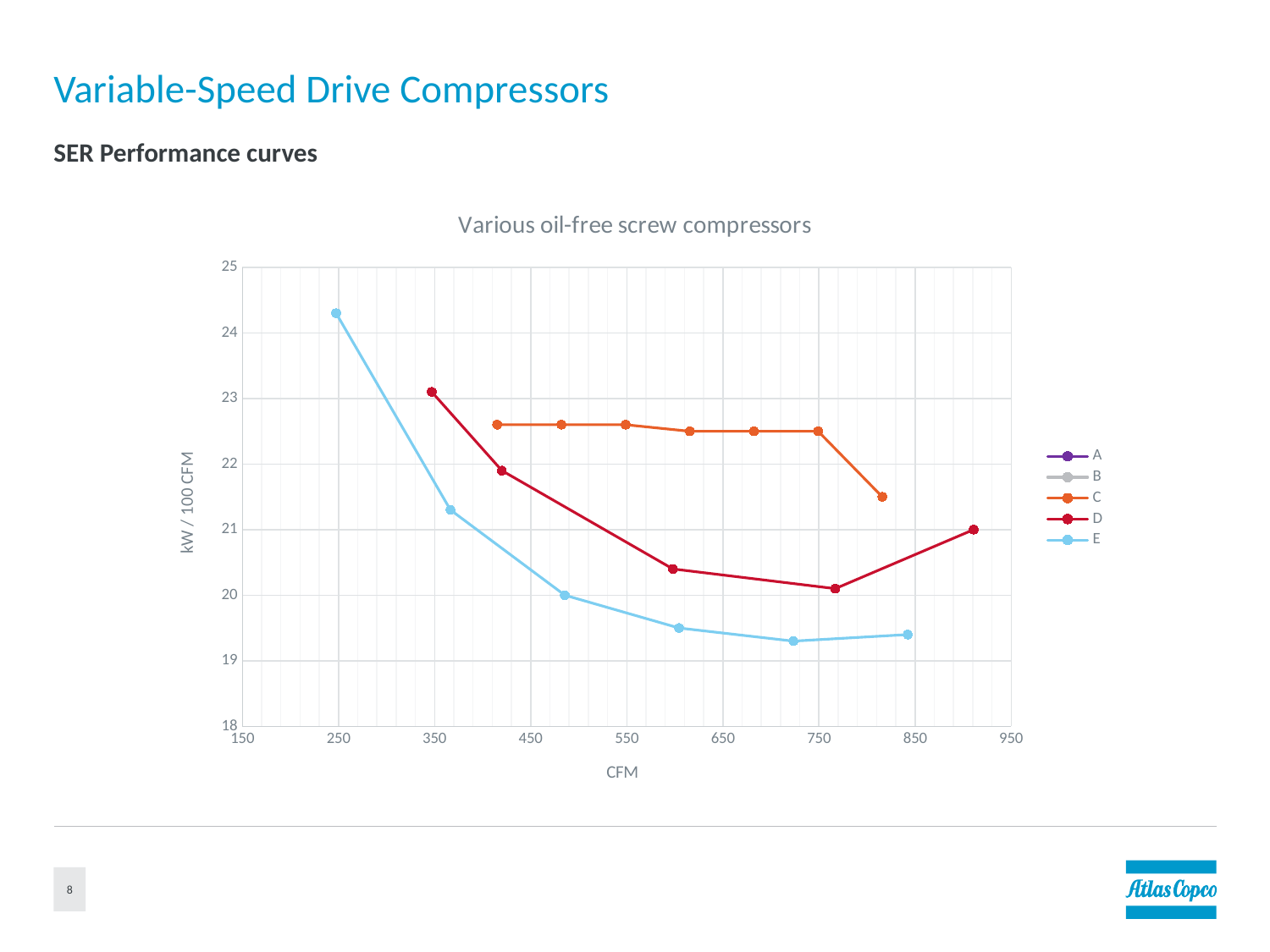
Is the lowest point of series E greater or less than 20? less How many data points are plotted for series E? 6 What kind of chart is shown on the slide? line chart Which series reaches the lowest value on the chart? E At around 615 CFM, which series has the higher value, C or E? C Which series reaches the highest value on the chart? E How many data points are plotted for series C? 7 Is the last (rightmost) value of series C greater or less than 21? greater How many series does the legend list? 5 Is the first (leftmost) value of series E greater or less than 24? greater What is the title of the chart? Various oil-free screw compressors What is the label of the vertical axis? kW / 100 CFM